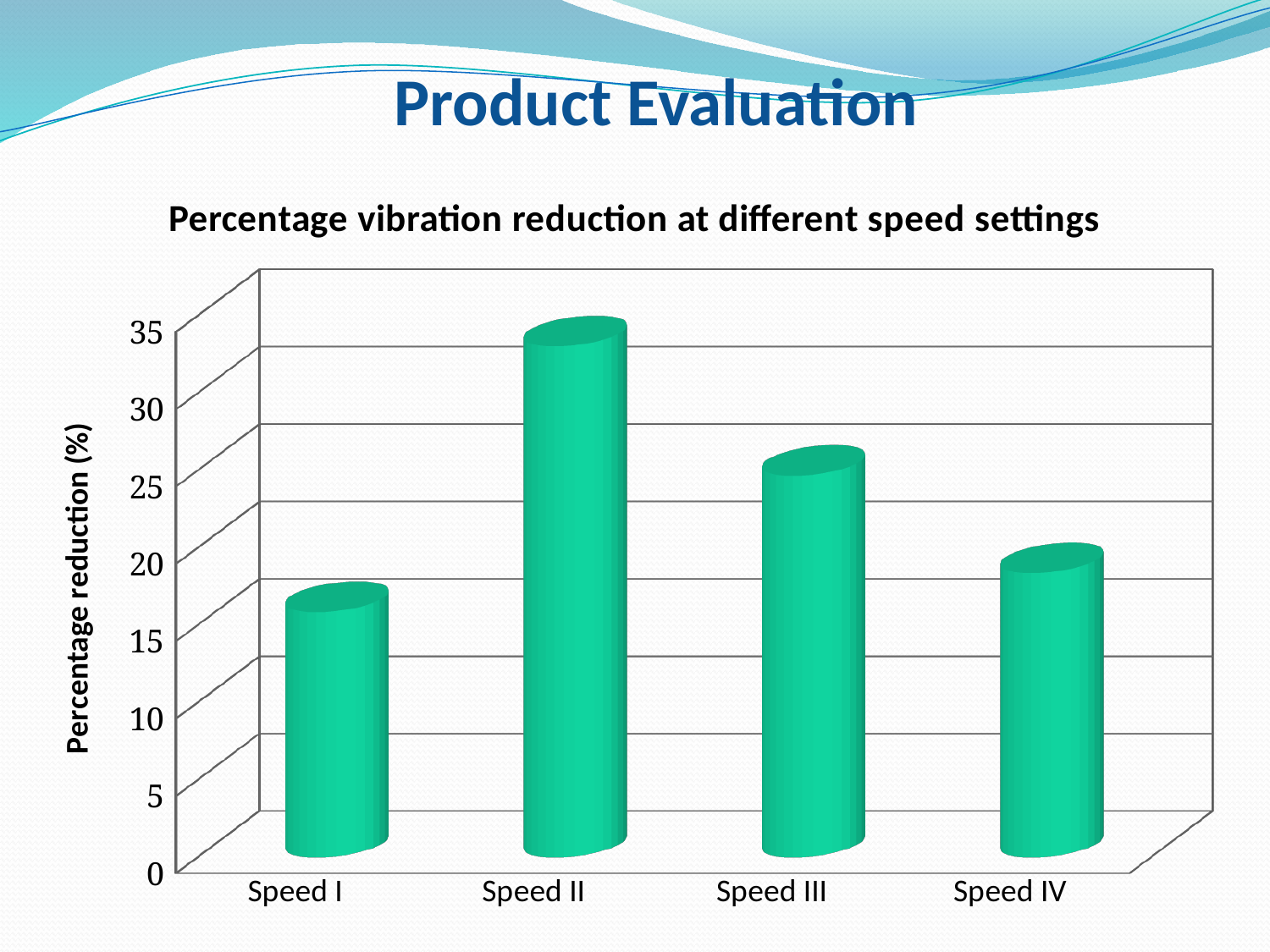
Which has a larger percentage reduction, Speed I or Speed II? Speed II Is the value for Speed II greater or less than 30? greater Do the values rise or fall from Speed II to Speed IV? fall What kind of chart is shown on the slide? bar chart What is the label on the vertical axis of the chart? Percentage reduction (%) Is the value for Speed IV greater or less than 15? greater Which has a larger percentage reduction, Speed III or Speed IV? Speed III Which speed setting has the lowest percentage vibration reduction? Speed I How many speed settings are plotted on the chart? 4 Is the value for Speed III greater or less than 30? less Which speed setting has the highest percentage vibration reduction? Speed II